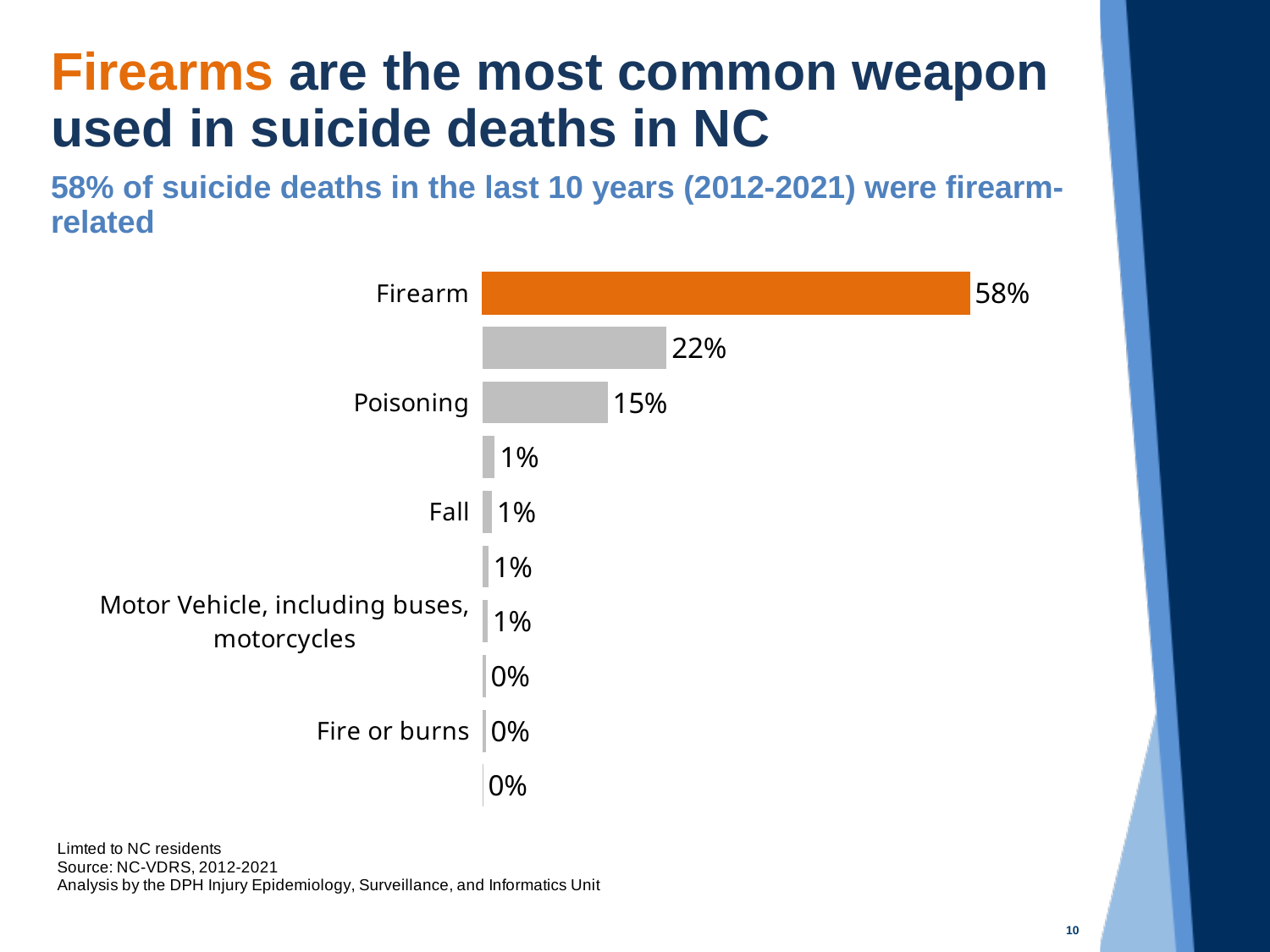
What percentage of suicide deaths is shown for Firearm? 58% What percentage is shown for Poisoning? 15% Which category has the highest percentage? Firearm What percentage is shown for Motor Vehicle, including buses, motorcycles? 1% Which is larger, the value for Poisoning or the value for Fall? Poisoning What percentage is shown for Fall? 1% What kind of chart is shown on the slide? Bar chart What is the difference in percentage points between Firearm and Poisoning? 43 percentage points How many bars are plotted in the chart? 10 What percentage is shown for Fire or burns? 0% What is the difference in percentage points between Poisoning and Fall? 14 percentage points What colour is the Firearm bar? Orange